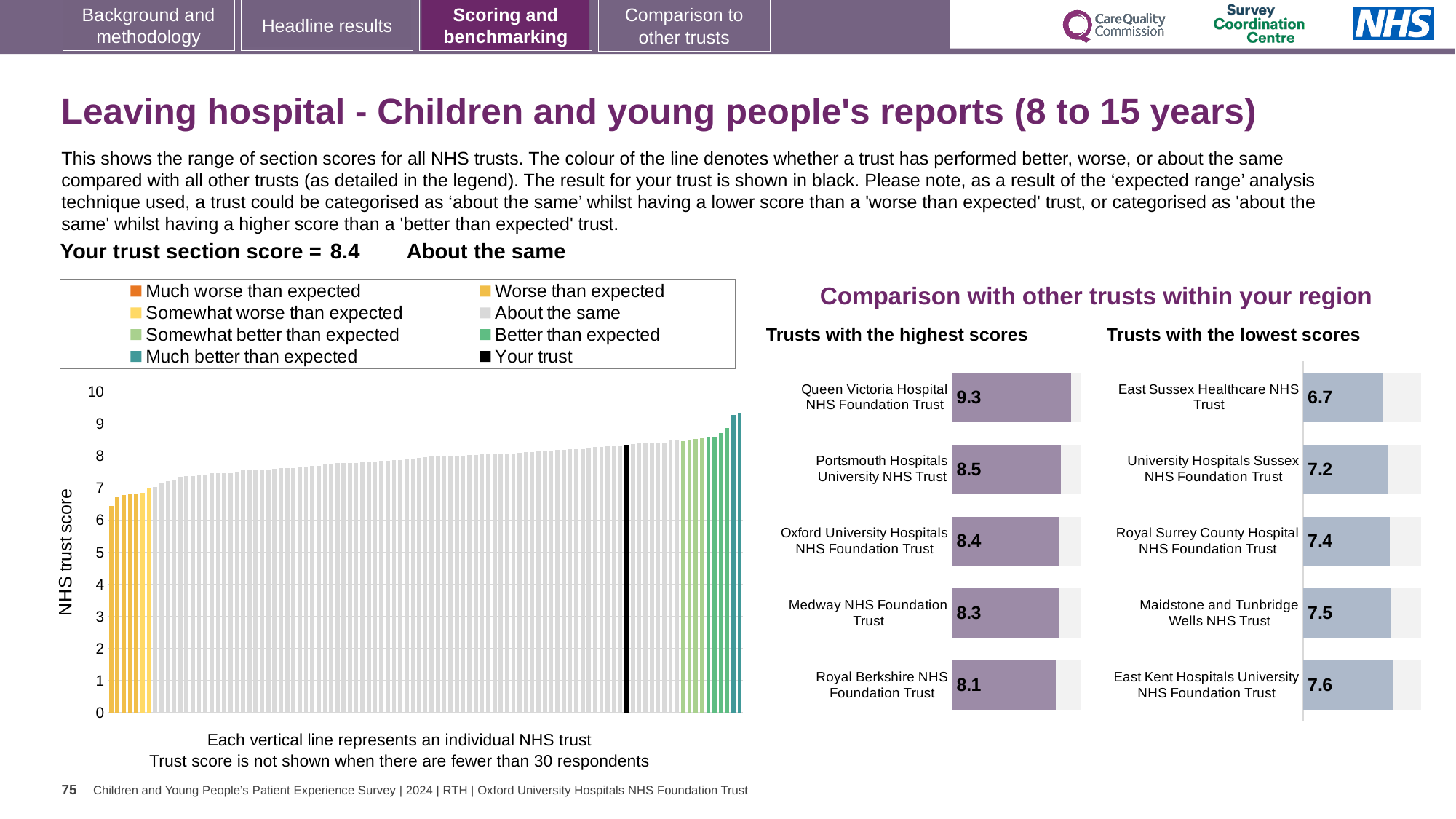
In the 'Trusts with the lowest scores' chart, what is the score for East Sussex Healthcare NHS Trust? 6.7 What kind of chart is the large 'NHS trust score' chart on the left of the slide? Bar chart In the 'Trusts with the lowest scores' chart, which trust has the lowest score? East Sussex Healthcare NHS Trust In the 'Trusts with the highest scores' chart, which trust has the highest score? Queen Victoria Hospital NHS Foundation Trust How many entries does the legend above the large 'NHS trust score' chart list? 8 How many trusts are shown in the 'Trusts with the lowest scores' chart? 5 In the 'Trusts with the lowest scores' chart, how much higher is East Kent Hospitals University NHS Foundation Trust's score than East Sussex Healthcare NHS Trust's? 0.9 In the 'Trusts with the highest scores' chart, what is the difference between the scores of Queen Victoria Hospital NHS Foundation Trust and Royal Berkshire NHS Foundation Trust? 1.2 In the large 'NHS trust score' chart on the left, is the value of the lowest bar greater or less than 7? less In the large 'NHS trust score' chart on the left, do the bars rise or fall from left to right? Rise In the 'Trusts with the highest scores' chart, which has the larger score: Portsmouth Hospitals University NHS Trust or Medway NHS Foundation Trust? Portsmouth Hospitals University NHS Trust In the 'Trusts with the highest scores' chart, what is the score for Queen Victoria Hospital NHS Foundation Trust? 9.3